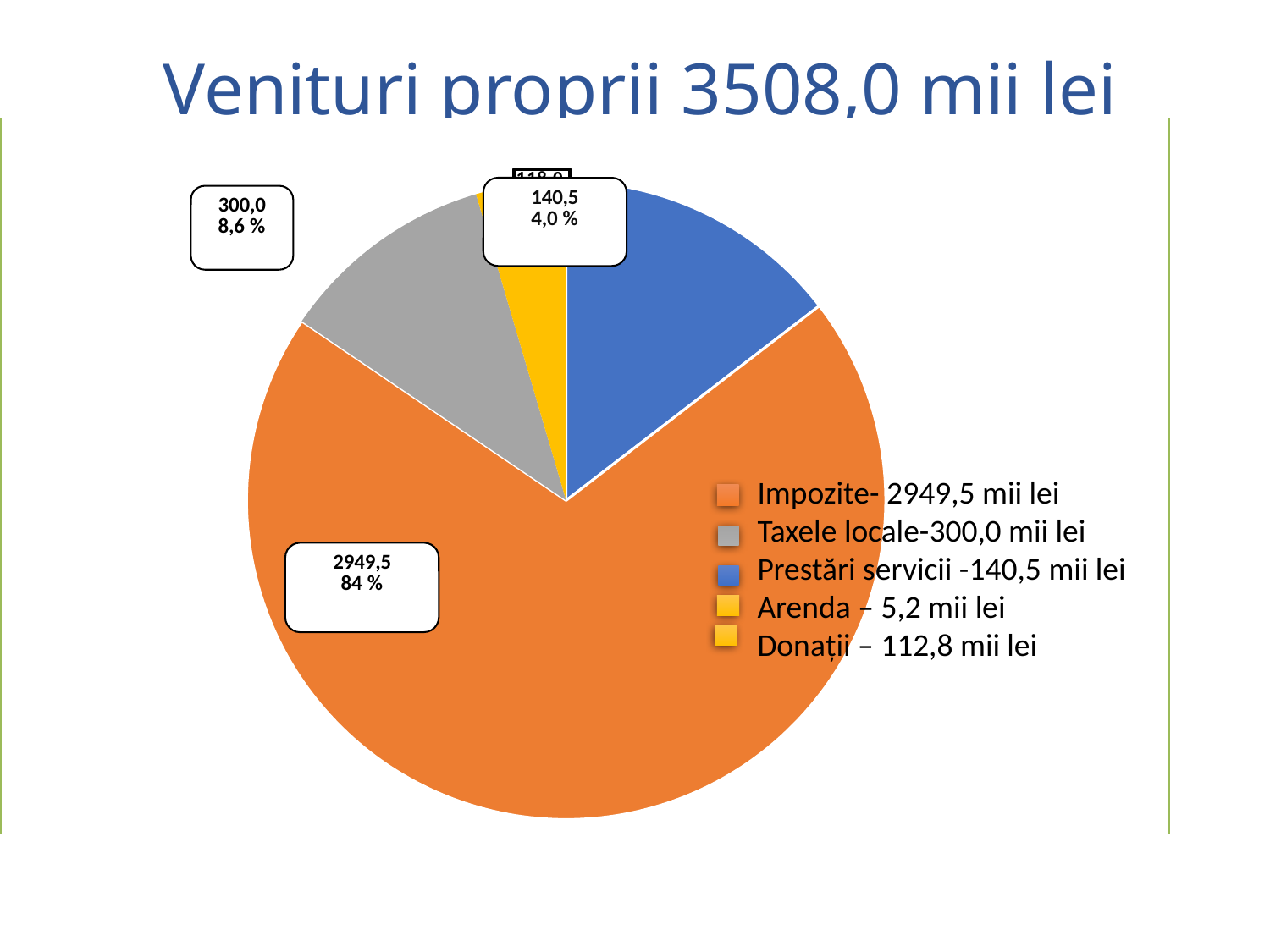
How many categories does the legend of the pie chart list? 5 What is the title of the slide? Venituri proprii 3508,0 mii lei Which category has the smallest value in the legend? Arenda What is the value for Taxele locale according to the legend? 300,0 mii lei What share of the pie does Taxele locale represent, as labelled on the chart? 8,6 % What share of the pie does Impozite represent, as labelled on the chart? 84 % What is the difference between the values for Taxele locale and Prestări servicii? 159,5 mii lei Which category has the largest slice of the pie? Impozite What is the value for Prestări servicii according to the legend? 140,5 mii lei What is the value for Impozite according to the legend? 2949,5 mii lei What is the value for Arenda according to the legend? 5,2 mii lei What kind of chart is shown on the slide? Pie chart